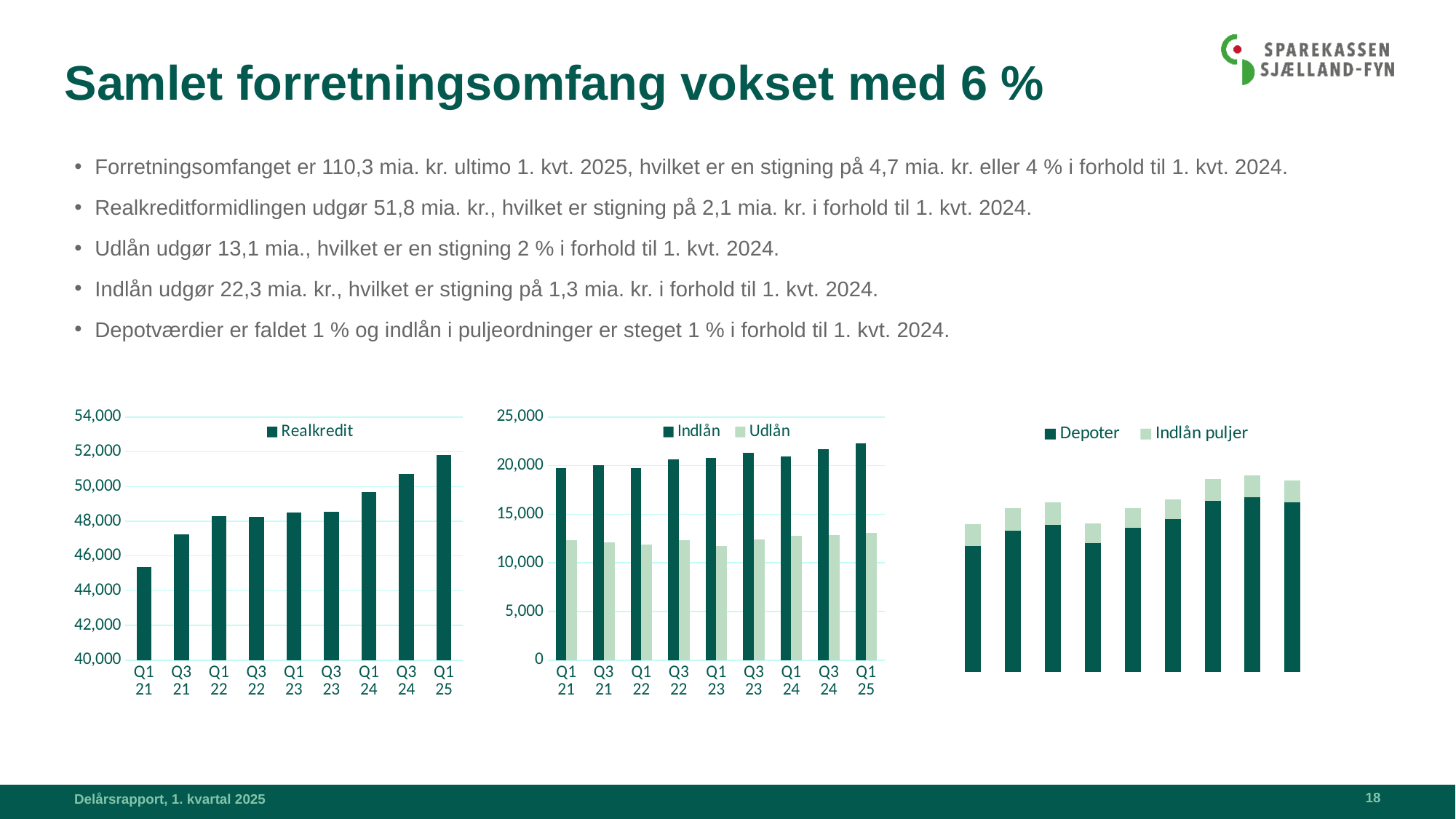
In the middle chart, is the Udlån value for Q1 21 greater or less than 15,000? less Which two series does the legend of the right chart list? Depoter and Indlån puljer In the left chart (Realkredit), is the value for Q1 21 greater or less than 46,000? less In the left chart (Realkredit), which quarter has the lowest value? Q1 21 In the left chart (Realkredit), is the value for Q1 25 greater or less than 50,000? greater What type of chart is the left chart titled Realkredit? bar chart In the left chart (Realkredit), how many quarters are shown on the x axis? 9 In the left chart (Realkredit), do the values generally rise or fall from Q1 21 to Q1 25? rise How many series does the legend of the middle chart list? 2 In the left chart (Realkredit), which quarter has the highest value? Q1 25 In the middle chart, which is larger for Q1 25, Indlån or Udlån? Indlån